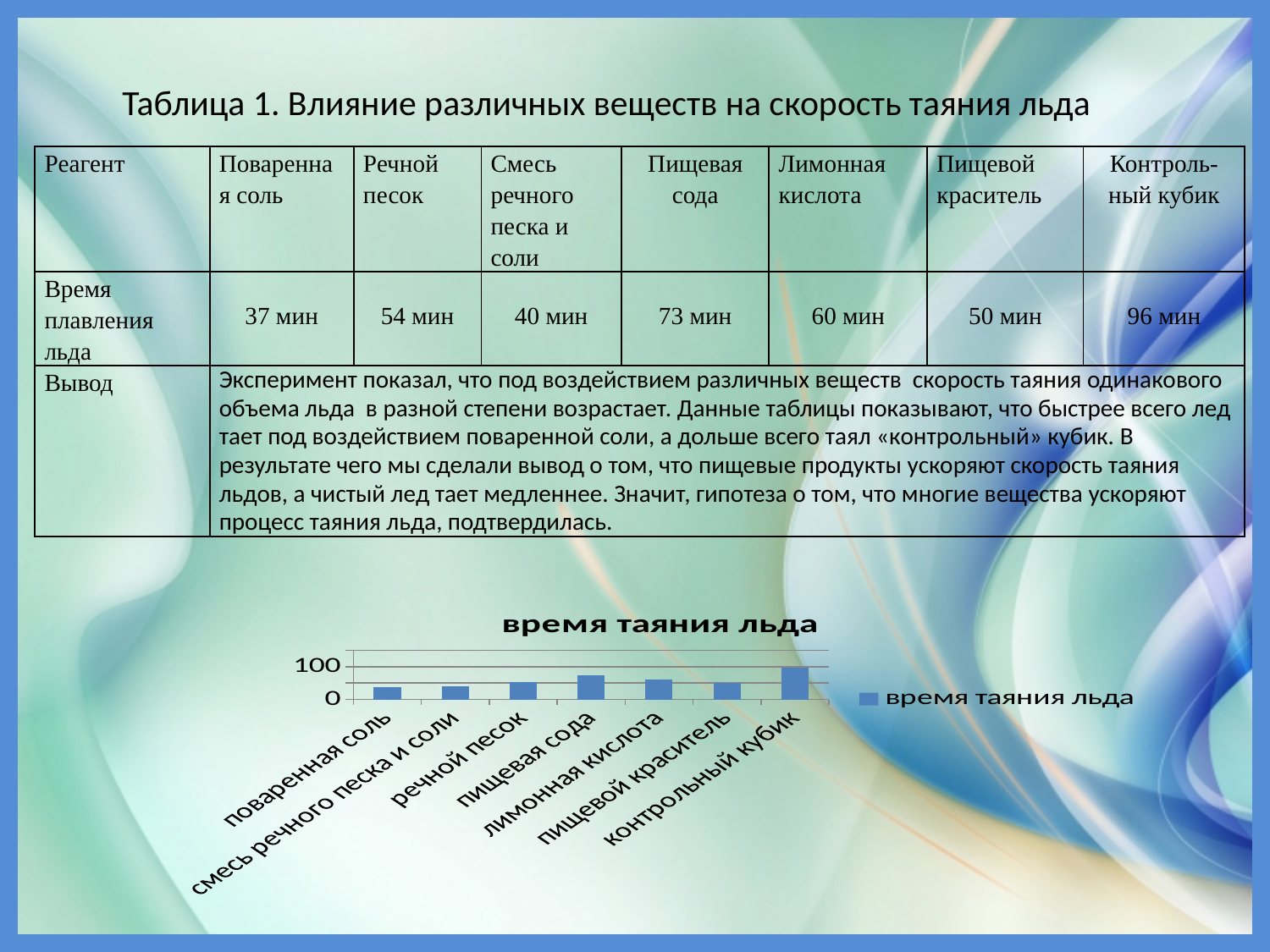
How many series does the chart legend list? 1 Which bar is taller in the chart: контрольный кубик or лимонная кислота? контрольный кубик What is the name of the series shown in the chart legend? время таяния льда What is the title of the chart? время таяния льда Which bar is taller in the chart: пищевая сода or речной песок? пищевая сода Is the value for контрольный кубик in the chart greater or less than 100? less Which category is plotted first (leftmost) on the x axis of the chart? поваренная соль Which category has the tallest bar in the chart? контрольный кубик Which bar is taller in the chart: лимонная кислота or поваренная соль? лимонная кислота How many categories are plotted on the x axis of the chart? 7 Is the value for пищевая сода in the chart greater or less than 100? less What kind of chart is shown on the slide? bar chart